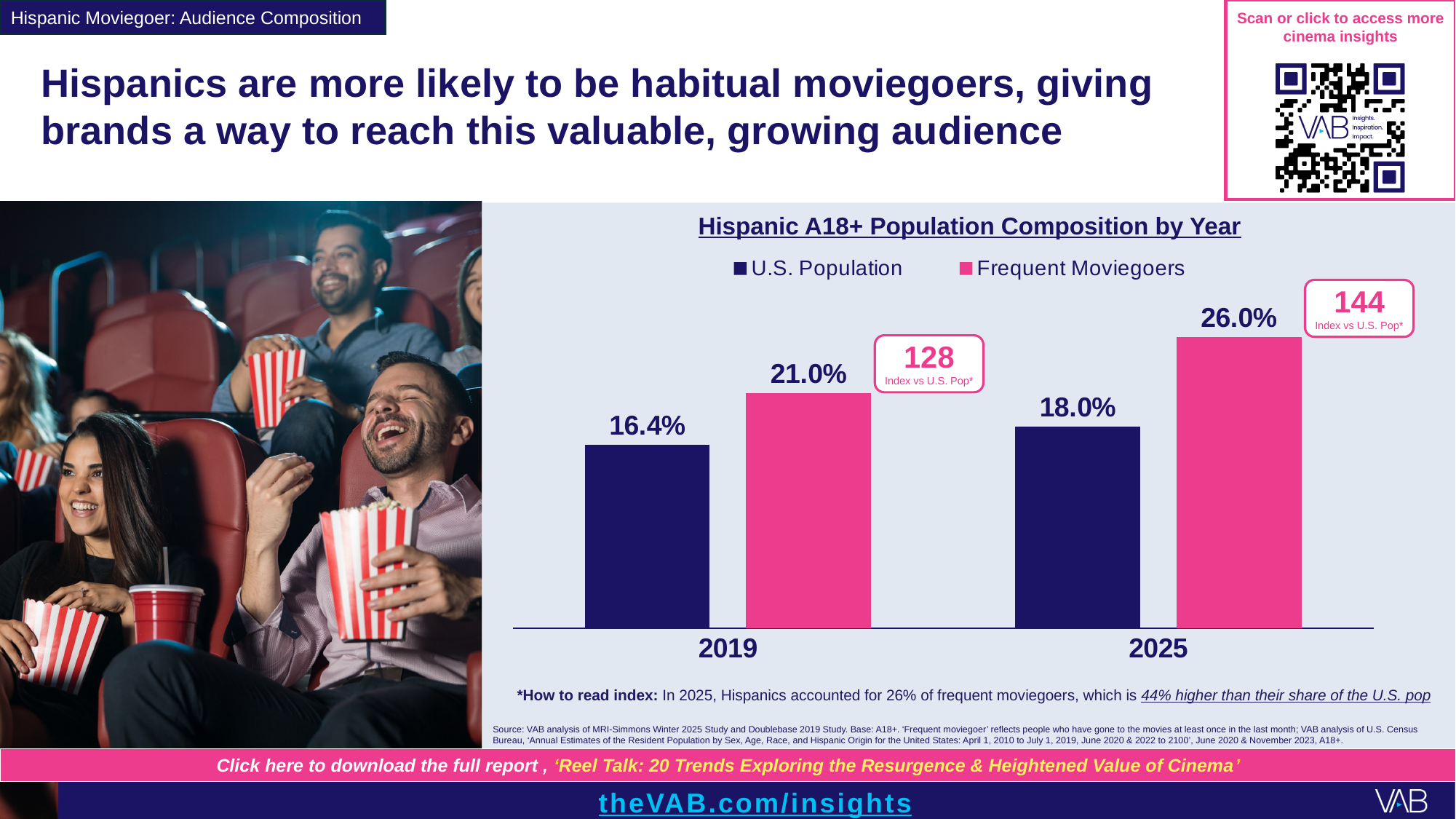
Which is larger in 2019: U.S. Population or Frequent Moviegoers? Frequent Moviegoers Which year has the lowest U.S. Population value? 2019 What is the index vs U.S. Pop shown for 2025? 144 Which year has the highest Frequent Moviegoers value? 2025 How many series does the legend list? 2 What is the U.S. Population value for 2025? 18.0% What is the U.S. Population value for 2019? 16.4% What kind of chart is shown? Bar chart What is the Frequent Moviegoers value for 2019? 21.0% What is the Frequent Moviegoers value for 2025? 26.0% How many years are shown on the x axis? 2 What is the difference between the Frequent Moviegoers and U.S. Population values in 2025? 8.0%